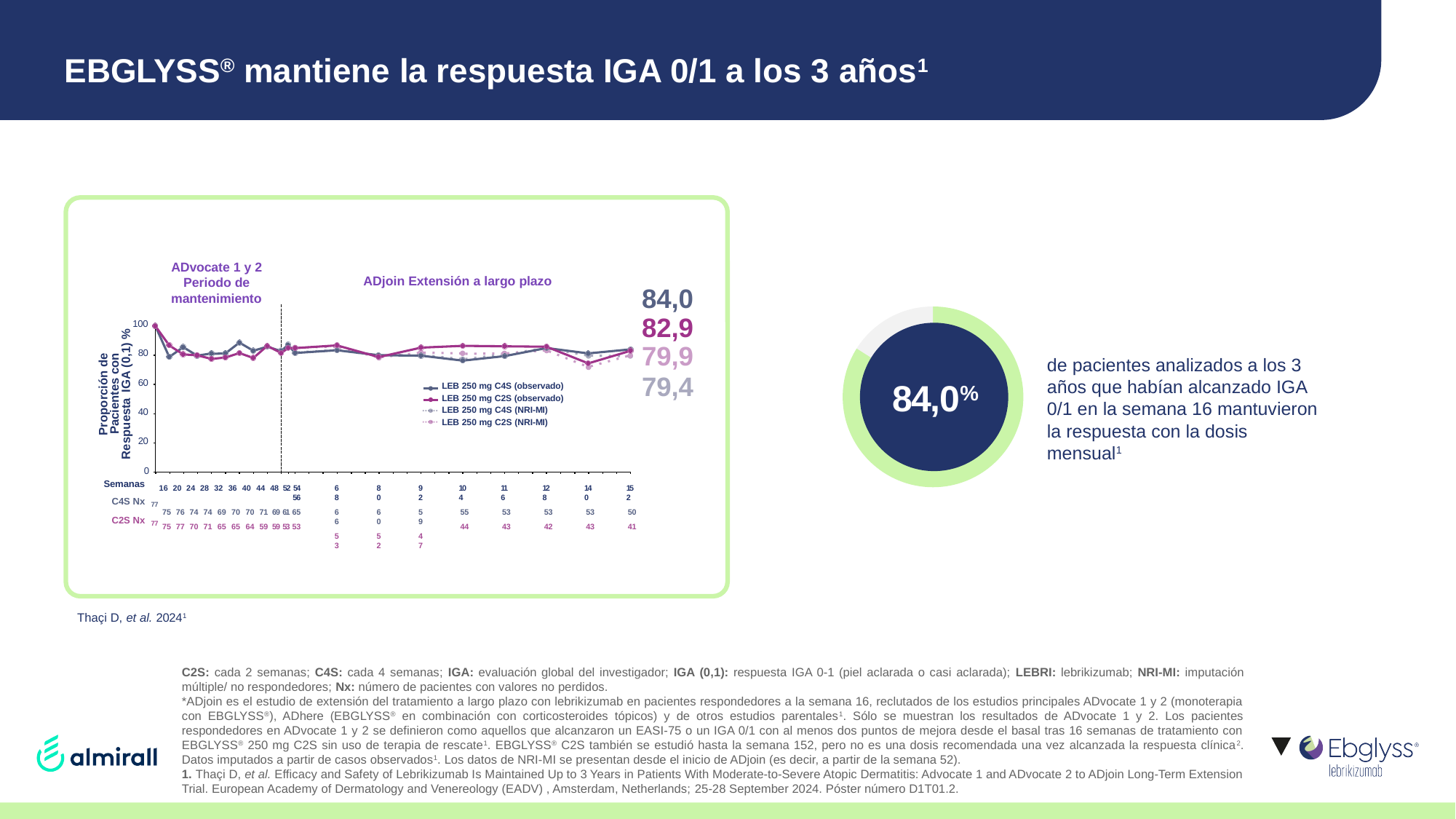
What is the label of the y axis of the line chart? Proporción de Pacientes con Respuesta IGA (0,1) % How many series does the legend of the line chart list? 4 What kind of chart is the chart on the right of the slide? Donut chart On the line chart, what is the highest of the four final values printed at the right of the plot? 84,0 On the line chart, what is the final value shown for the magenta series, LEB 250 mg C2S (observado)? 82,9 On the line chart, what is the final value shown at the top of the right-hand labels (the dark blue series, LEB 250 mg C4S observado)? 84,0 On the line chart, what is the difference between the final values 84,0 and 82,9? 1,1 What percentage is shown in the centre of the donut chart on the right? 84,0% On the line chart, which final value is larger: 82,9 or 79,9? 82,9 On the line chart, what is the lowest of the four final values printed at the right of the plot? 79,4 On the line chart, is the value at week 16 greater or less than 80? greater What kind of chart is the chart on the left of the slide? Line chart